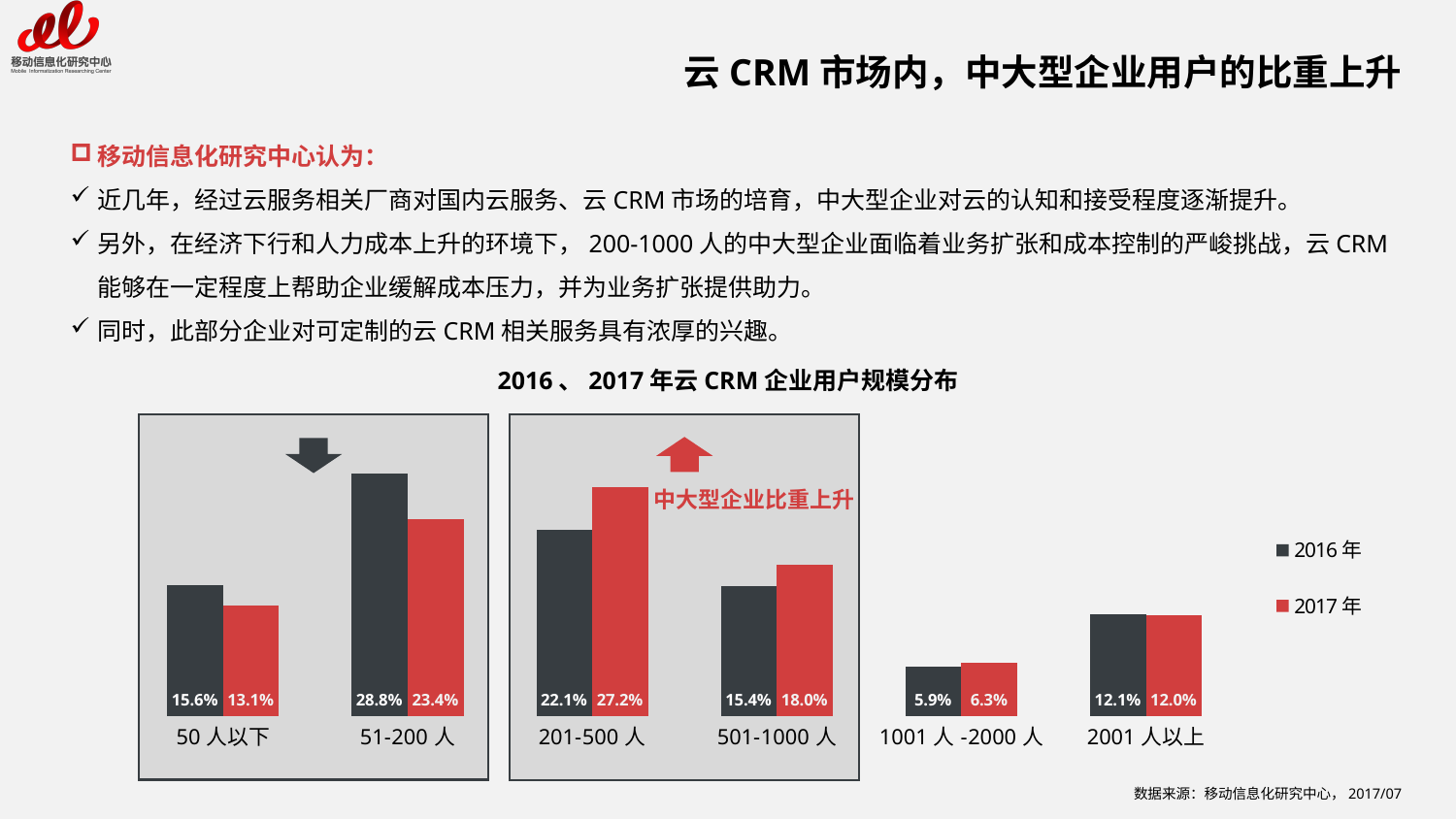
What is the title of the chart? 2016、2017 年云 CRM 企业用户规模分布 What is the 2017年 value for 1001 人 -2000 人? 6.3% Which category has the highest 2016年 value? 51-200 人 What is the 2016年 value for 51-200 人? 28.8% How many company-size categories are shown on the x axis? 6 How many series does the legend list? 2 Which category has the lowest 2017年 value? 1001 人 -2000 人 What is the 2017年 value for 201-500 人? 27.2% Which is larger for 501-1000 人, the 2016年 value or the 2017年 value? 2017年 What is the difference between the 2016年 and 2017年 values for 51-200 人? 5.4% What kind of chart is shown on the slide? Bar chart What is the 2016年 value for 2001 人以上? 12.1%